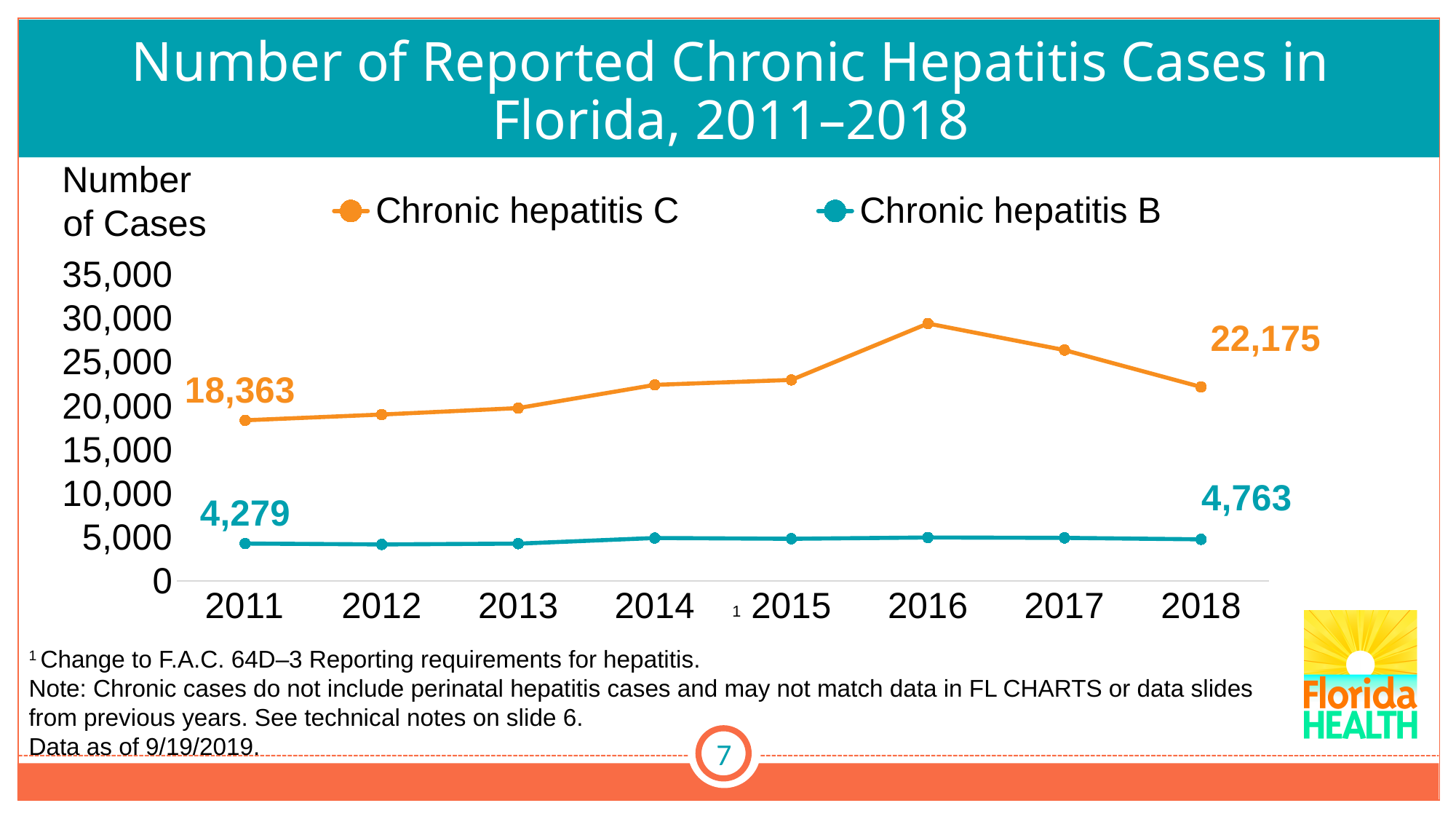
What was the number of reported chronic hepatitis B cases in Florida in 2011? 4,279 What was the number of reported chronic hepatitis B cases in Florida in 2018? 4,763 How many years are shown on the x axis? 8 What kind of chart is shown on the slide? Line chart Which series had more cases in 2016, chronic hepatitis C or chronic hepatitis B? Chronic hepatitis C Is the value for chronic hepatitis C in 2016 greater or less than 25,000? greater How many series does the legend list? 2 What was the number of reported chronic hepatitis C cases in Florida in 2011? 18,363 What was the number of reported chronic hepatitis C cases in Florida in 2018? 22,175 In which year did chronic hepatitis C cases peak? 2016 By how much did chronic hepatitis B cases increase from 2011 to 2018? 484 By how much did chronic hepatitis C cases increase from 2011 to 2018? 3,812